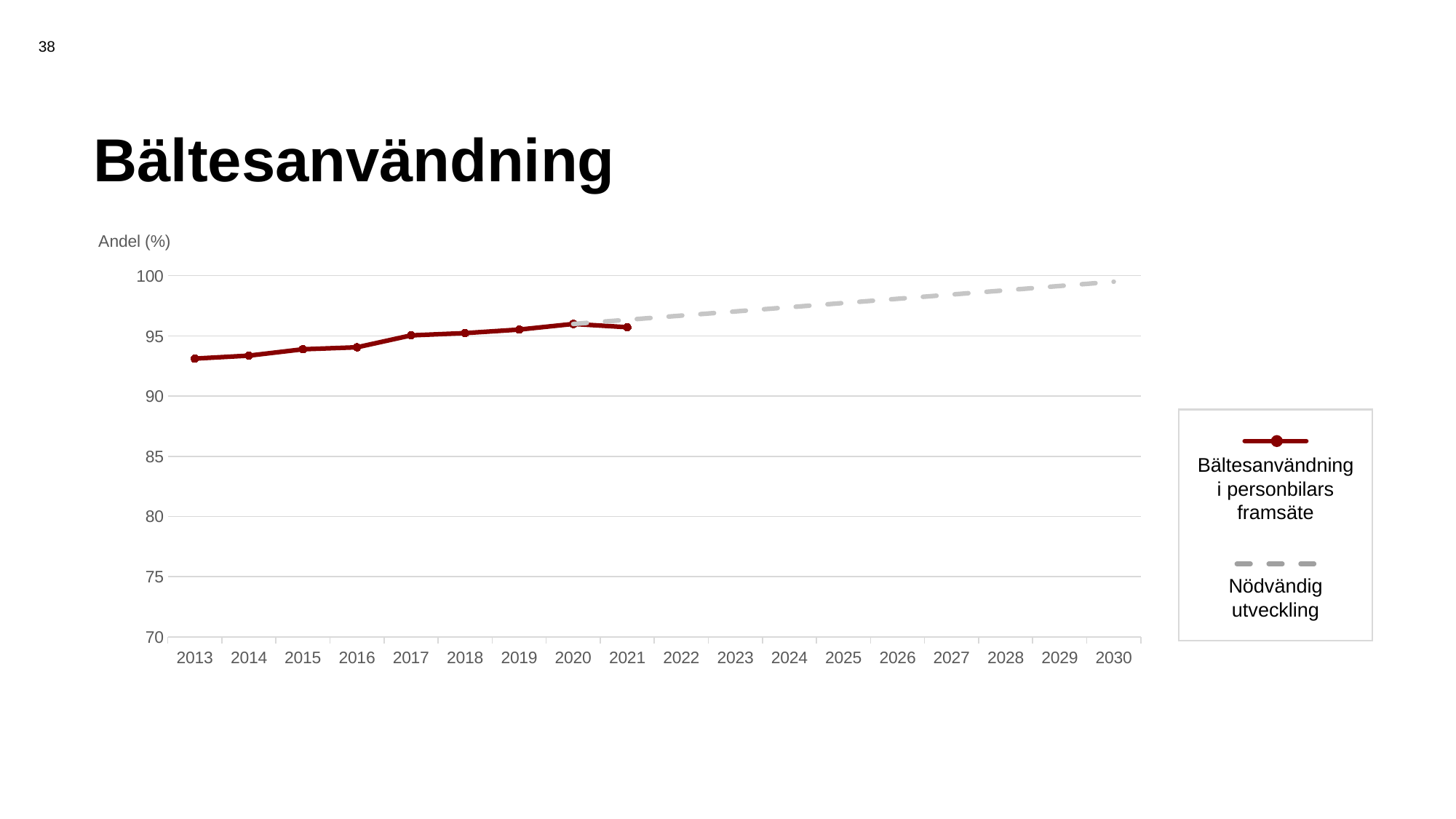
Is the value for 2021 on the 'Bältesanvändning i personbilars framsäte' line greater or less than 95? greater Does the 'Bältesanvändning i personbilars framsäte' line generally rise or fall from 2013 to 2020? rise Is the value for 2030 on the 'Nödvändig utveckling' line greater or less than 100? less What is the label of the vertical axis? Andel (%) Which series is drawn as a grey dashed line? Nödvändig utveckling How many series does the legend list? 2 Is the value for 2030 on the 'Nödvändig utveckling' line greater or less than 95? greater How many data points does the 'Bältesanvändning i personbilars framsäte' line have? 9 Which is larger on the 'Bältesanvändning i personbilars framsäte' line, the value for 2013 or the value for 2021? 2021 What kind of chart is shown on the slide? line chart